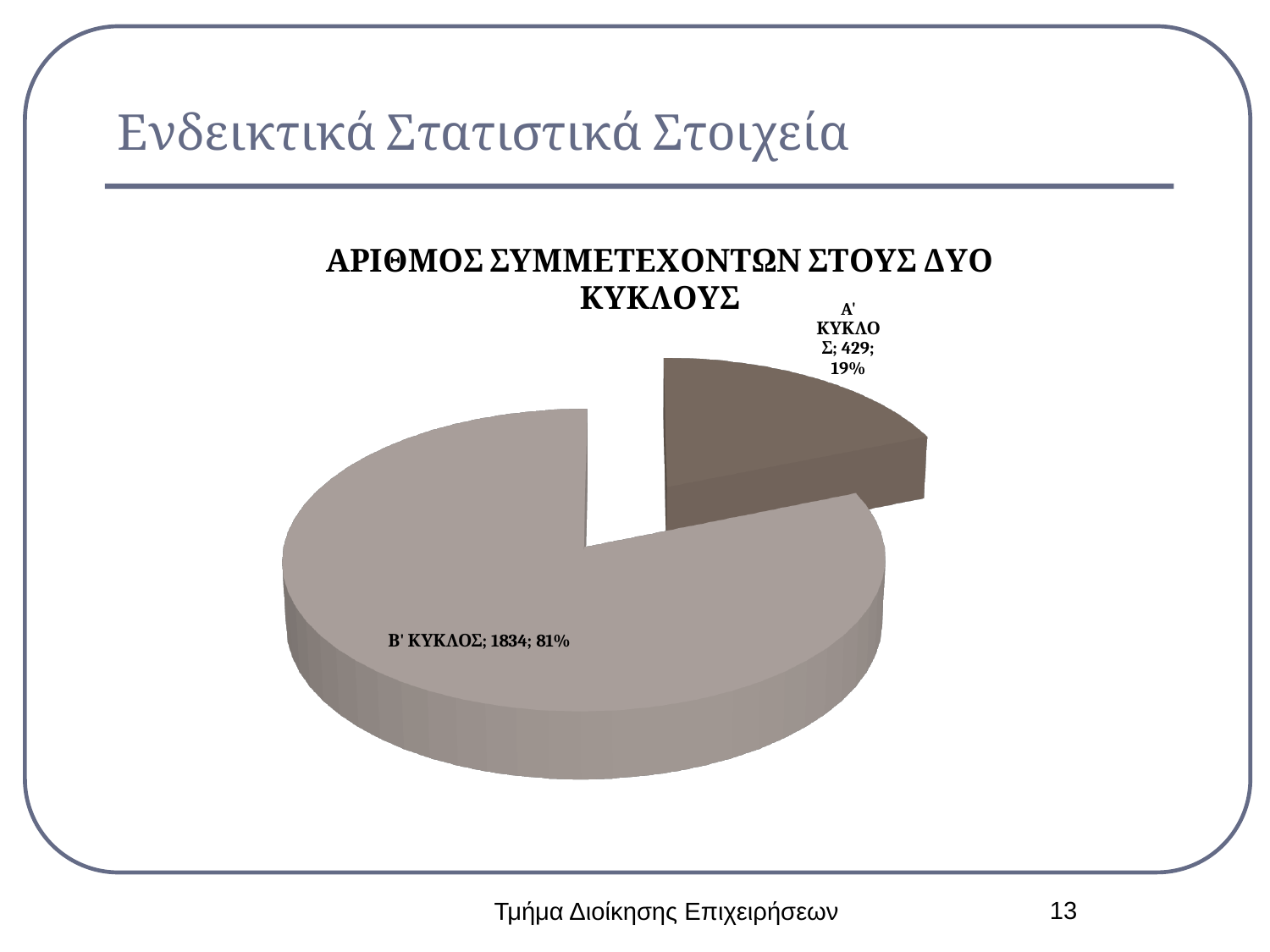
How many slices does the pie chart have? 2 What is the total of the two slices in the pie chart? 2263 Which slice is the smallest? Α' ΚΥΚΛΟΣ What share of the pie does Β' ΚΥΚΛΟΣ represent? 81% Which is larger, the value for Α' ΚΥΚΛΟΣ or Β' ΚΥΚΛΟΣ? Β' ΚΥΚΛΟΣ What kind of chart is shown on the slide? Pie chart What is the value for Α' ΚΥΚΛΟΣ? 429 What is the title of the chart? ΑΡΙΘΜΟΣ ΣΥΜΜΕΤΕΧΟΝΤΩΝ ΣΤΟΥΣ ΔΥΟ ΚΥΚΛΟΥΣ What share of the pie does Α' ΚΥΚΛΟΣ represent? 19% What is the difference between the values for Β' ΚΥΚΛΟΣ and Α' ΚΥΚΛΟΣ? 1405 Which slice is the largest? Β' ΚΥΚΛΟΣ What is the value for Β' ΚΥΚΛΟΣ? 1834